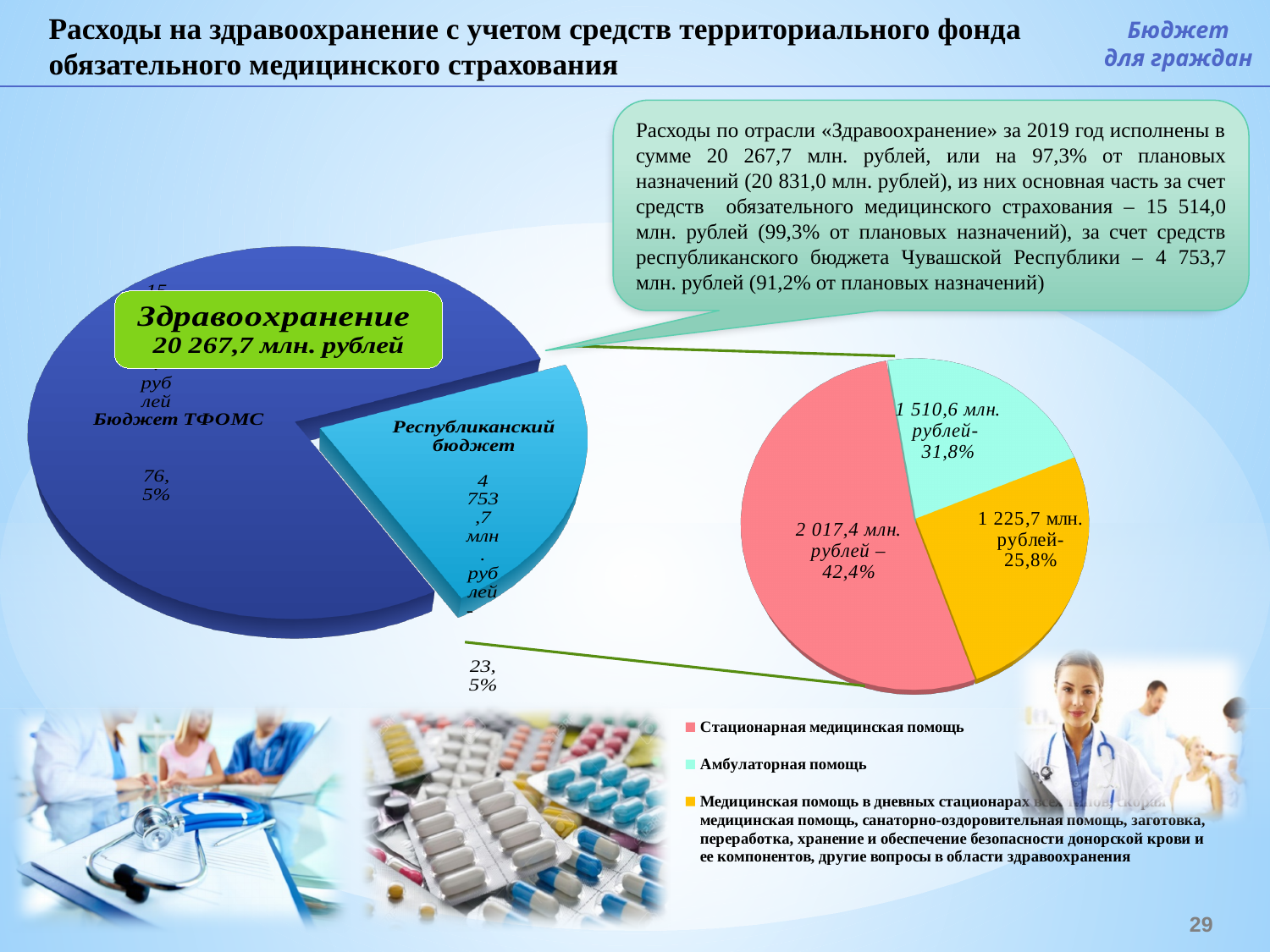
In the pie chart on the right, which is larger: Амбулаторная помощь or Стационарная медицинская помощь? Стационарная медицинская помощь In the pie chart on the right, what share does Амбулаторная помощь have? 31,8% In the pie chart on the right, how many slices are there? 3 In the pie chart on the right, what value is shown for Стационарная медицинская помощь? 2 017,4 млн. рублей – 42,4% In the pie chart on the left, what share does Бюджет ТФОМС have? 76,5% In the pie chart on the right, what amount in млн. рублей is shown for Амбулаторная помощь? 1 510,6 млн. рублей In the pie chart on the right, what is the difference in percentage points between Стационарная медицинская помощь (42,4%) and Амбулаторная помощь (31,8%)? 10,6 In the pie chart on the right, what share does the yellow slice (Медицинская помощь в дневных стационарах ...) have? 25,8% What kind of chart is the chart on the right side of the slide? pie chart In the pie chart on the right, which category has the largest slice? Стационарная медицинская помощь